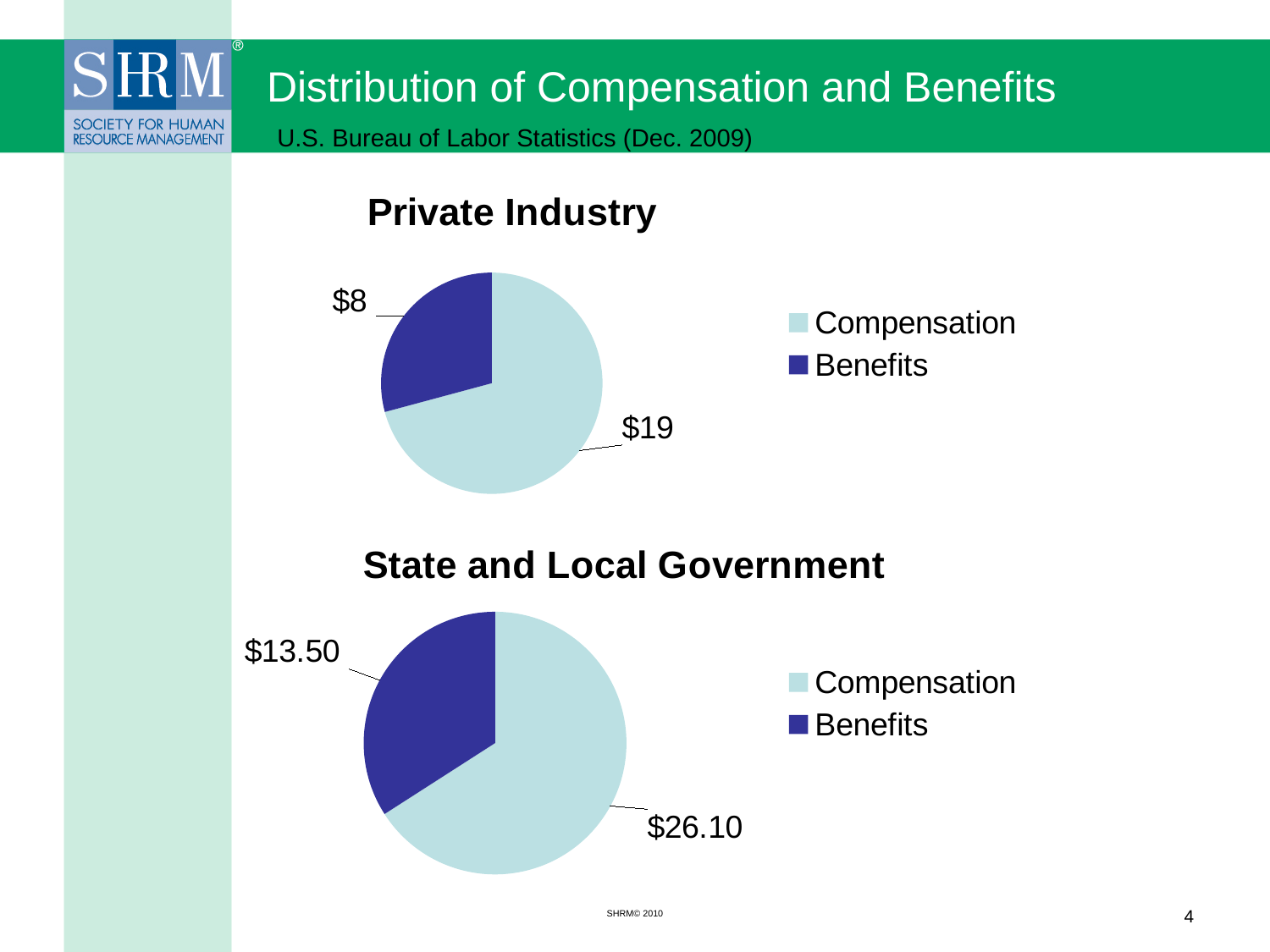
In the Private Industry chart, what is the value for Compensation? $19 How many slices does the State and Local Government pie chart have? 2 In the Private Industry chart, what is the difference between Compensation and Benefits? $11 In the State and Local Government chart, what is the value for Compensation? $26.10 In the Private Industry chart, which slice is the largest? Compensation Is the Benefits value larger in the Private Industry chart or in the State and Local Government chart? State and Local Government What type of chart is the Private Industry chart? Pie chart In the Private Industry chart, what is the value for Benefits? $8 In the State and Local Government chart, which slice is the smallest? Benefits In the State and Local Government chart, what is the value for Benefits? $13.50 In the State and Local Government chart, what is the difference between Compensation and Benefits? $12.60